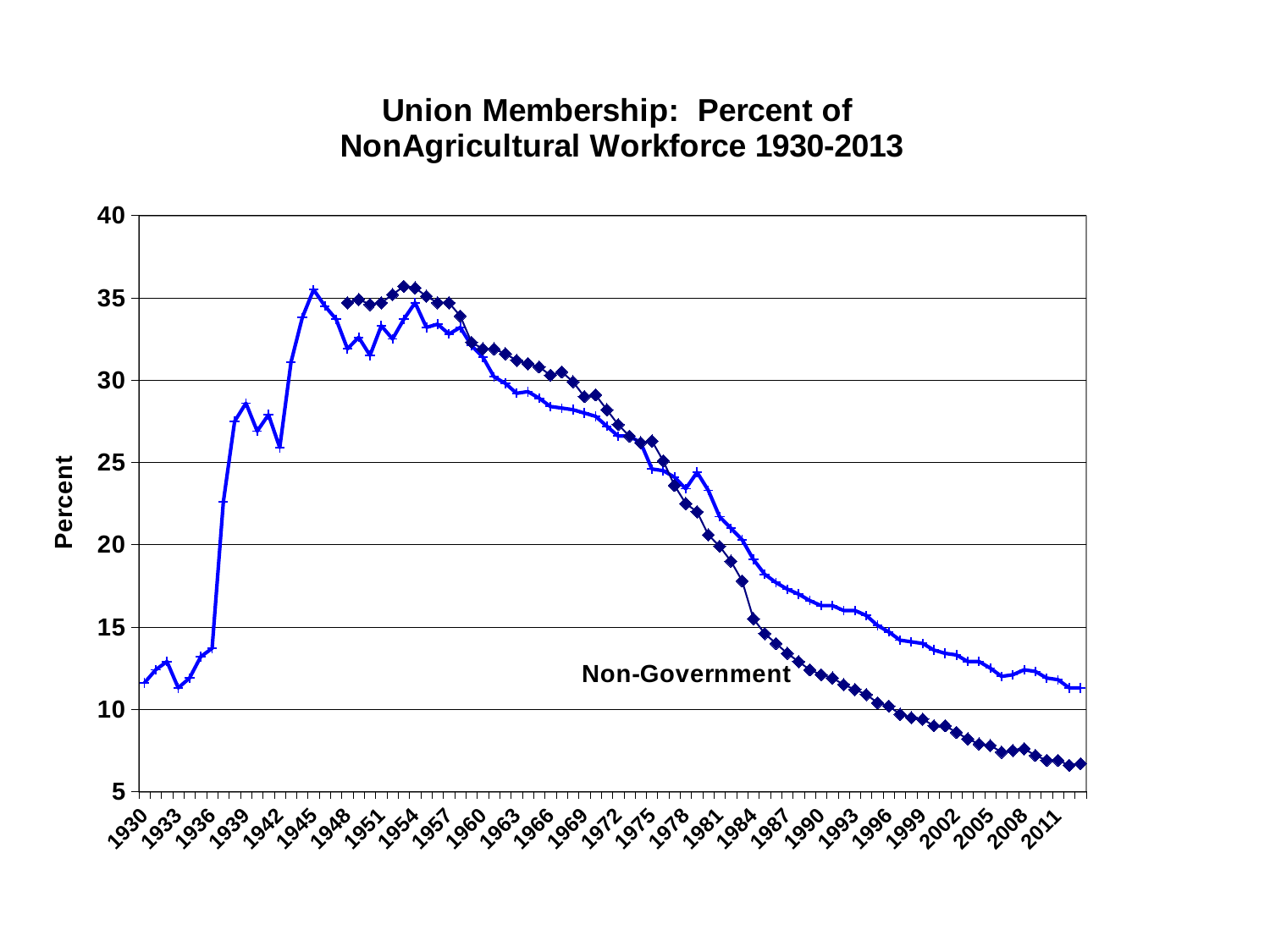
Is the value of the line with plus markers for 2011 greater or less than 10? greater What kind of chart is shown on the slide? line chart What is the title of the chart? Union Membership: Percent of NonAgricultural Workforce 1930-2013 What label is printed on the chart next to the line with diamond markers? Non-Government Is the value of the line with plus markers for 1939 greater or less than 30? less In 2011, which line is higher: the Non-Government line or the line with plus markers? the line with plus markers Is the Non-Government value for 1984 greater or less than 20? less Does the Non-Government line rise or fall from 1984 to 2013? fall Is the Non-Government value larger in 1954 or in 1984? 1954